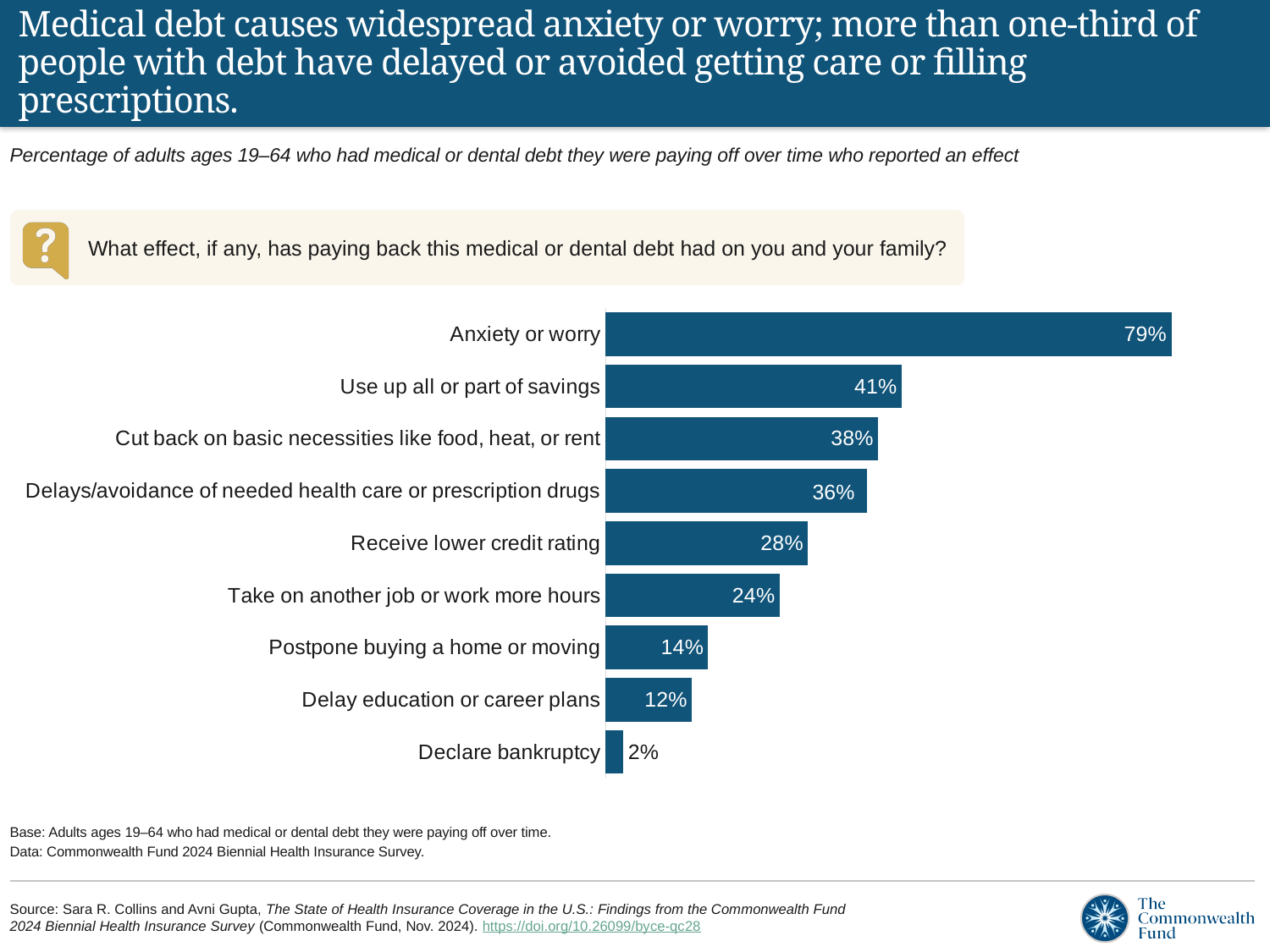
What percentage reported declaring bankruptcy? 2% What is the difference in percentage points between 'Anxiety or worry' and 'Receive lower credit rating'? 51 percentage points What percentage reported delays/avoidance of needed health care or prescription drugs? 36% Which was reported by more adults: 'Postpone buying a home or moving' or 'Delay education or career plans'? Postpone buying a home or moving What type of chart is shown on the slide? Bar chart How many effects (categories) are shown in the chart? 9 What percentage of adults with medical or dental debt reported anxiety or worry? 79% What survey question is shown in the box above the chart? What effect, if any, has paying back this medical or dental debt had on you and your family? What is the difference in percentage points between 'Use up all or part of savings' and 'Cut back on basic necessities like food, heat, or rent'? 3 percentage points Which effect was reported by the highest percentage of adults? Anxiety or worry Which effect was reported by the lowest percentage of adults? Declare bankruptcy What percentage reported that they had to take on another job or work more hours? 24%